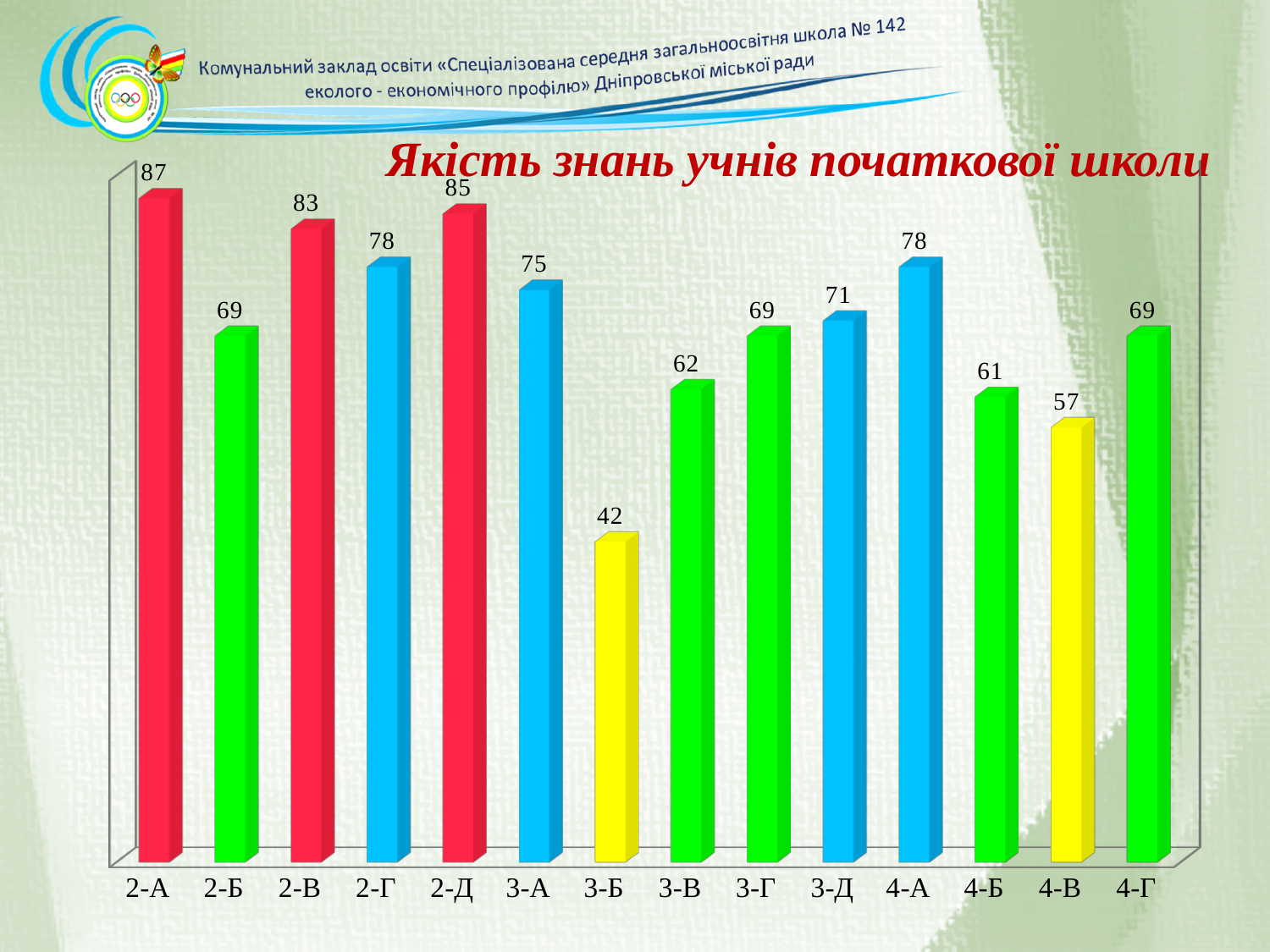
What is the title of the chart? Якість знань учнів початкової школи What is the difference between the values for 2-А and 3-Б? 45 What is the value for 4-В? 57 What is the value for 3-Д? 71 What kind of chart is shown on the slide? bar chart What is the value for 3-Б? 42 Which is larger, the value for 2-Д or the value for 3-А? 2-Д How many categories are shown on the chart? 14 Which category has the lowest value? 3-Б What is the difference between the values for 2-В and 4-Б? 22 What is the value for 2-А? 87 Which category has the highest value? 2-А